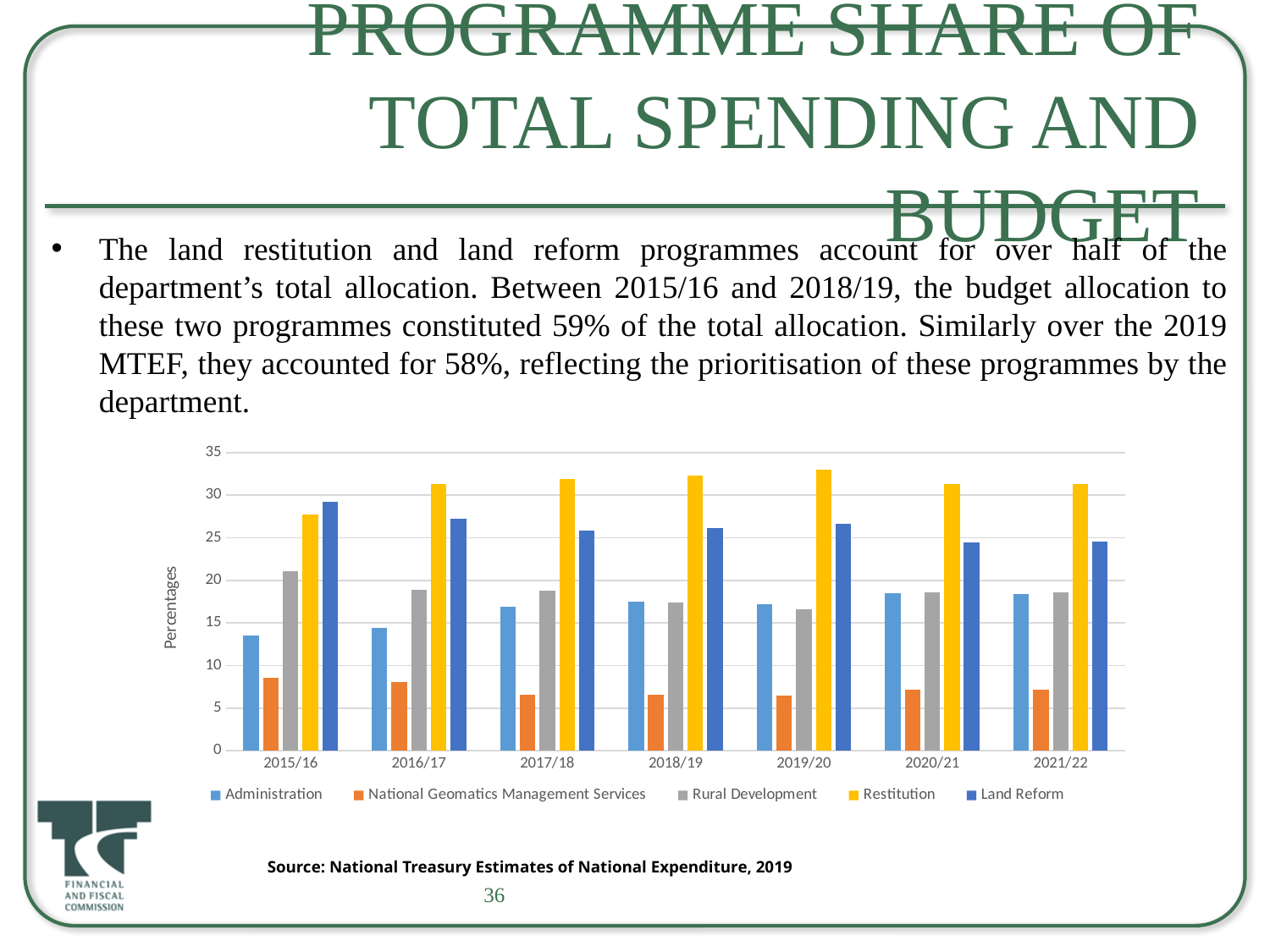
In 2015/16, which is larger: Land Reform or Restitution? Land Reform What is the label on the chart's y axis? Percentages Is the value for Restitution in 2019/20 greater or less than 30? greater Does the Land Reform share rise or fall from 2015/16 to 2021/22? fall What kind of chart is shown on the slide? bar chart Is the value for National Geomatics Management Services in 2017/18 greater or less than 10? less Which programme has the lowest share in 2015/16? National Geomatics Management Services Which programme has the highest share in 2019/20? Restitution How many financial years are shown on the x axis of the chart? 7 In 2016/17, which is larger: Restitution or Land Reform? Restitution Is the value for Administration in 2015/16 greater or less than 15? less How many series does the chart's legend list? 5